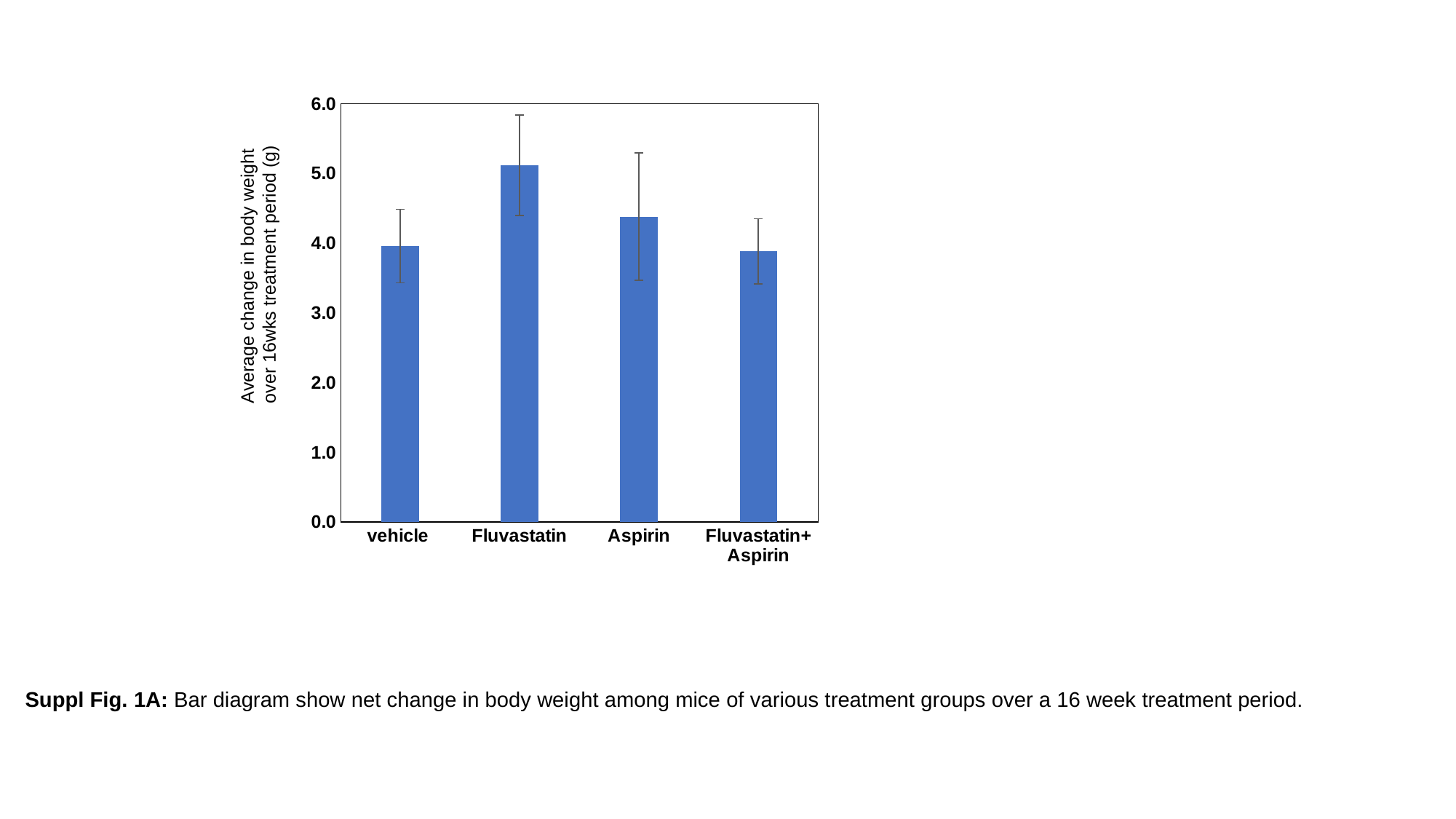
Is the value for vehicle greater or less than 5.0? less What is the label on the y axis of the chart? Average change in body weight over 16wks treatment period (g) What kind of chart is shown on the slide? bar chart Which is larger, the value for Aspirin or the value for vehicle? Aspirin Is the value for Fluvastatin greater or less than 4.0? greater Is the value for vehicle greater or less than 3.0? greater Which is larger, the value for Fluvastatin or the value for Aspirin? Fluvastatin How many treatment groups are plotted on the chart? 4 What colour are the bars in the chart? blue Which treatment group has the highest average change in body weight? Fluvastatin